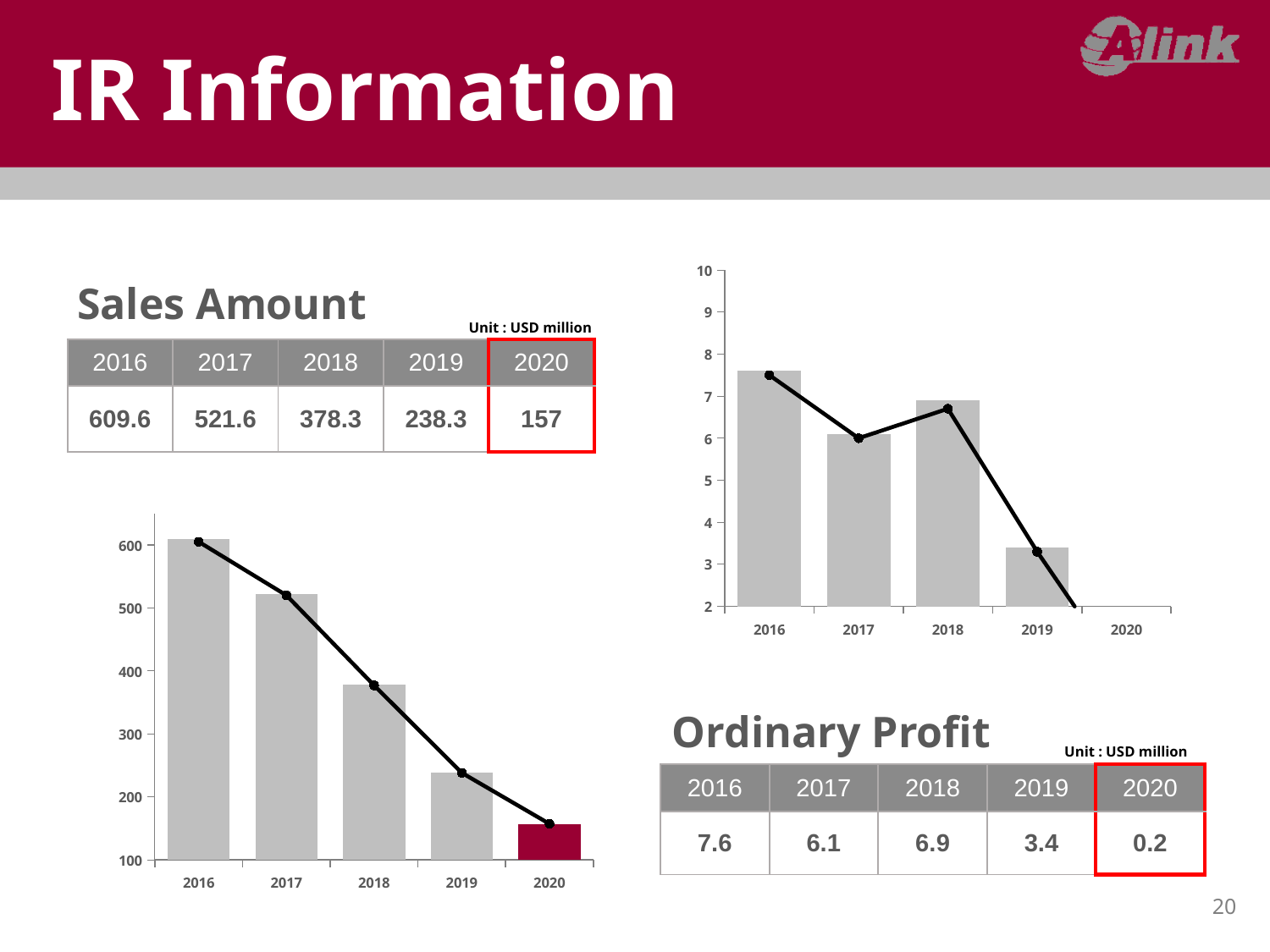
On the Sales Amount chart, which year has the lowest sales amount? 2020 On the Sales Amount chart, what is the sales amount for 2018? 378.3 On the Ordinary Profit chart, what is the ordinary profit for 2019? 3.4 On the Sales Amount chart, is the value for 2019 greater or less than 300? less On the Ordinary Profit chart, which year has the highest ordinary profit? 2016 On the Sales Amount chart, what is the difference between the 2016 and 2017 sales amounts? 88 On the Ordinary Profit chart, what is the difference between the 2018 and 2019 values? 3.5 On the Sales Amount chart, do the values rise or fall from 2016 to 2020? fall On the Sales Amount chart, what colour is the bar for 2020? dark red On the Sales Amount chart, which year has the highest sales amount? 2016 On the Ordinary Profit chart, which is larger, the value for 2017 or the value for 2018? 2018 On the Sales Amount chart, how many years are shown on the x axis? 5